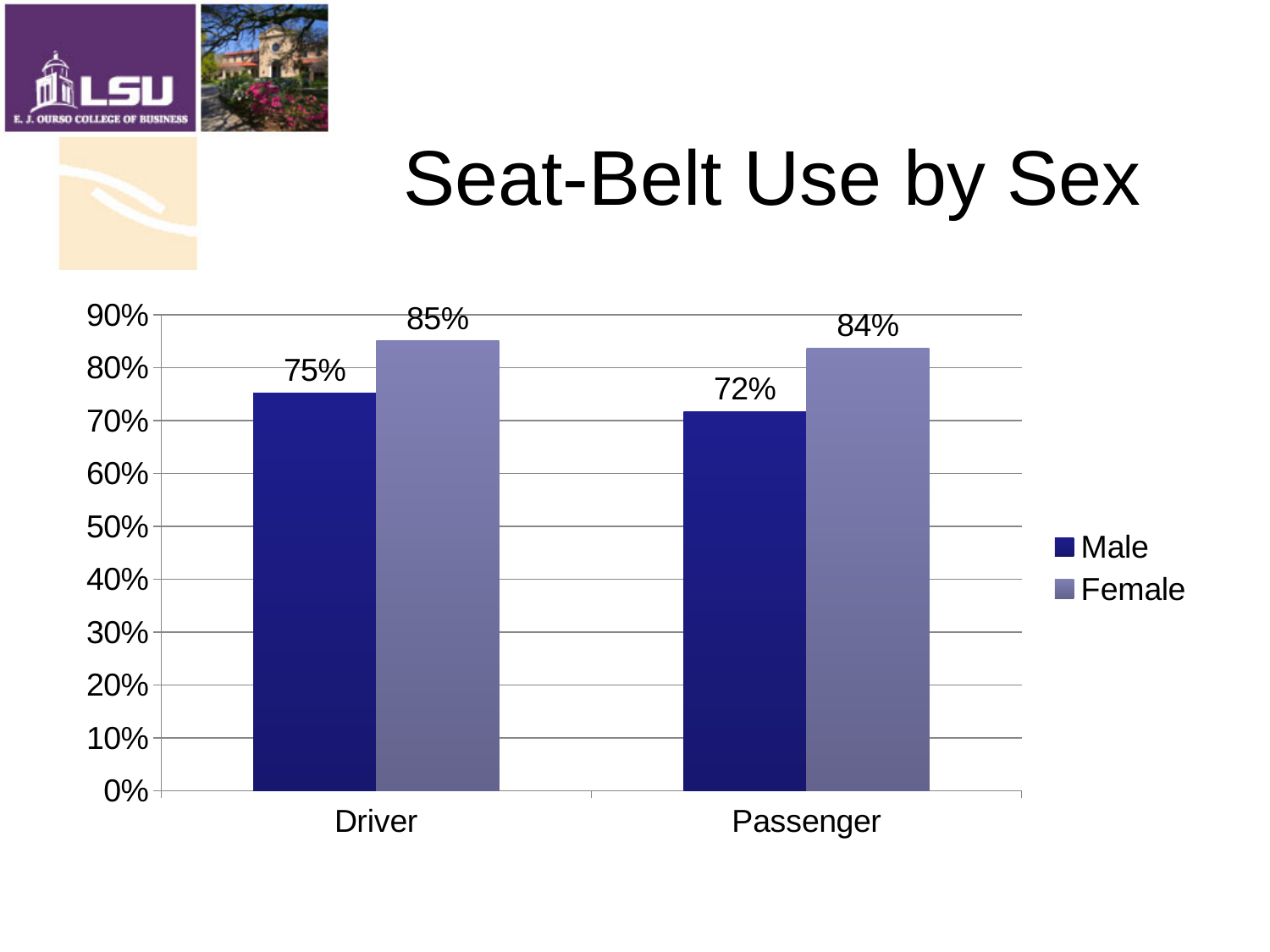
What kind of chart is shown on the slide? Bar chart How many series does the legend list? 2 What is the seat-belt use value for Male drivers? 75% Which group has the highest seat-belt use value on the chart? Female drivers What is the seat-belt use value for Female passengers? 84% What is the difference between the Female and Male values for Driver? 10% How many categories are shown on the x axis? 2 What is the seat-belt use value for Female drivers? 85% What is the difference between the Female and Male values for Passenger? 12% Which is larger, the Male value for Driver or the Male value for Passenger? Driver Which group has the lowest seat-belt use value on the chart? Male passengers What is the seat-belt use value for Male passengers? 72%